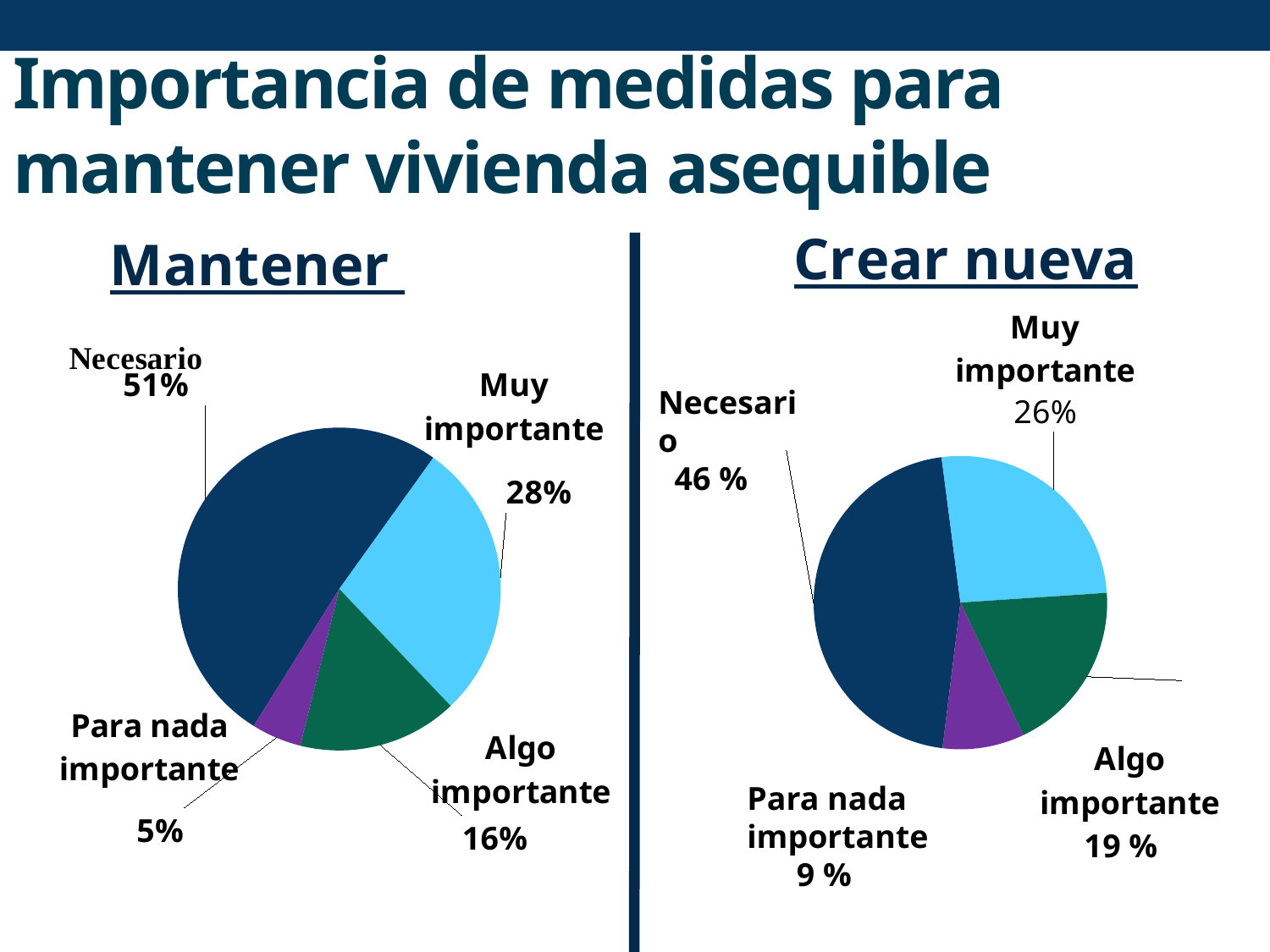
How many slices does the Crear nueva pie chart have? 4 In the Crear nueva pie chart, what percentage is labelled Necesario? 46 % In the Mantener pie chart, what percentage is labelled Necesario? 51% Which is larger: Muy importante in the Mantener chart or Muy importante in the Crear nueva chart? Mantener In the Crear nueva pie chart, what is the difference in percentage points between Muy importante and Algo importante? 7 In the Crear nueva pie chart, which category has the smallest slice? Para nada importante In the Mantener pie chart, what percentage is labelled Algo importante? 16% What type of chart is used on the left side of the slide under Mantener? Pie chart In the Crear nueva pie chart, what percentage is labelled Para nada importante? 9 % In the Mantener pie chart, which category has the largest slice? Necesario In the Mantener pie chart, what is the difference in percentage points between Necesario and Muy importante? 23 What colour is the Necesario slice in the Mantener pie chart? Dark blue